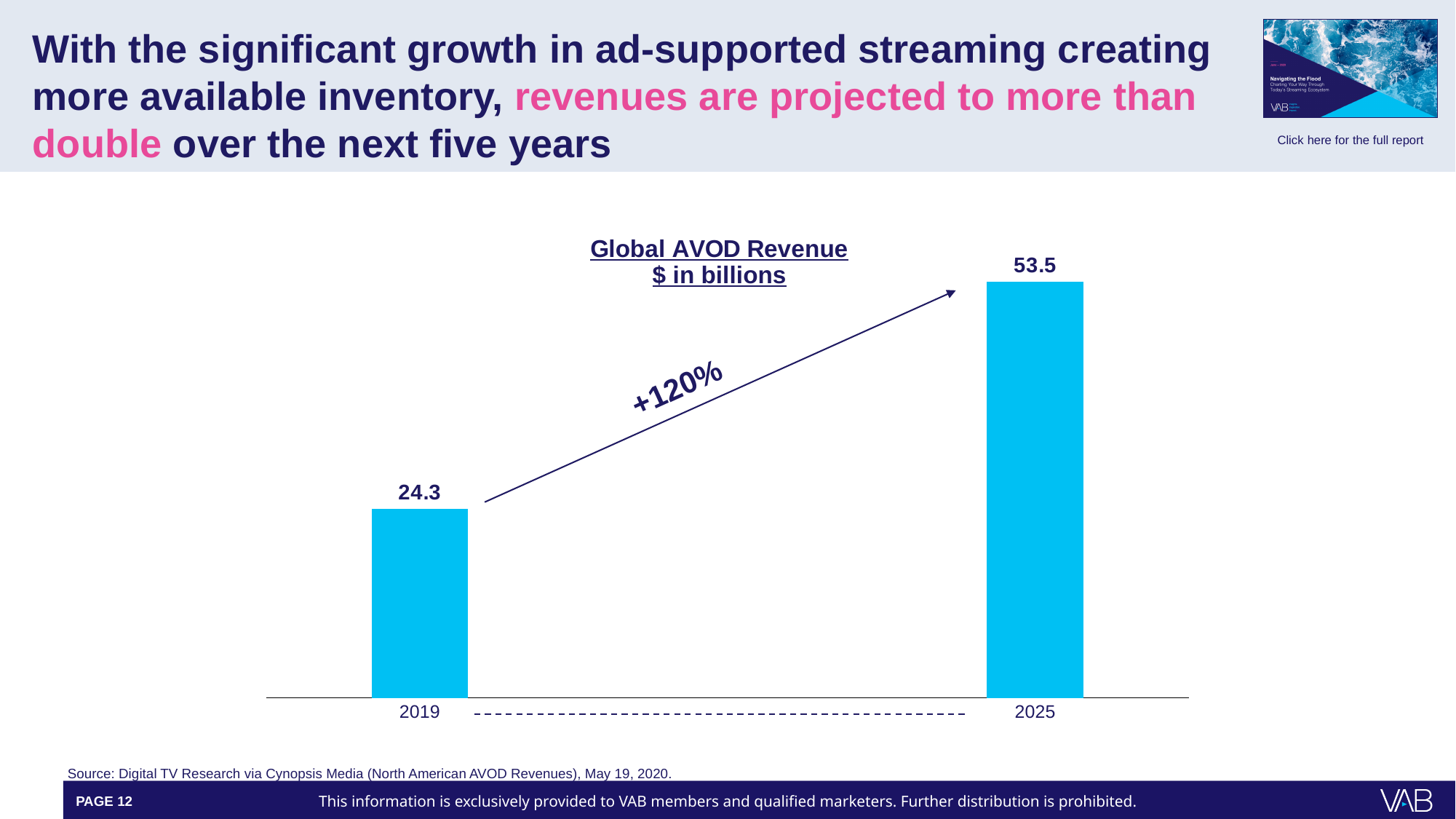
Which year has the higher Global AVOD Revenue, 2019 or 2025? 2025 What is the difference between the 2025 and 2019 Global AVOD Revenue values? 29.2 Which year shows the lowest Global AVOD Revenue on the chart? 2019 What percentage growth is labelled on the arrow between 2019 and 2025? +120% What is the title of the chart? Global AVOD Revenue $ in billions Does Global AVOD Revenue rise or fall from 2019 to 2025? Rise In what unit are the Global AVOD Revenue values expressed? $ in billions What is the Global AVOD Revenue value shown for 2025? 53.5 How many years (categories) are plotted on the Global AVOD Revenue chart? 2 What type of chart is used to show Global AVOD Revenue? Bar chart What is the Global AVOD Revenue value shown for 2019? 24.3